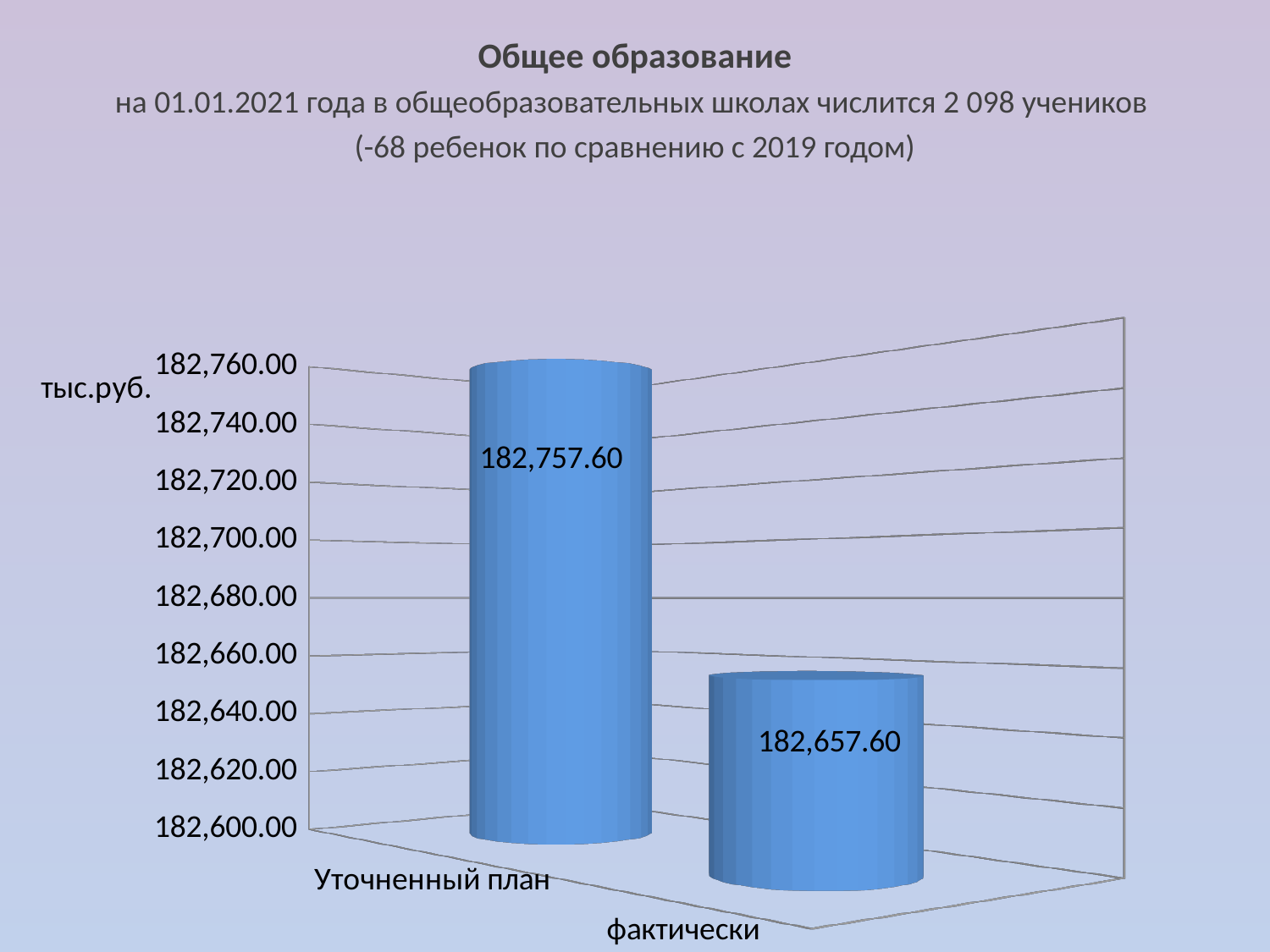
What kind of chart is shown on the slide? bar chart What is the difference between the values for Уточненный план and фактически? 100.00 Is the value for Уточненный план greater or less than 182,740.00? greater Do the values rise or fall from Уточненный план to фактически? fall What is the value for фактически? 182,657.60 Which category has the highest value? Уточненный план What is the value for Уточненный план? 182,757.60 Which is larger, the value for Уточненный план or the value for фактически? Уточненный план What unit label is shown on the vertical axis of the chart? тыс.руб. Which category has the lowest value? фактически Is the value for фактически greater or less than 182,700.00? less How many categories are shown in the chart? 2